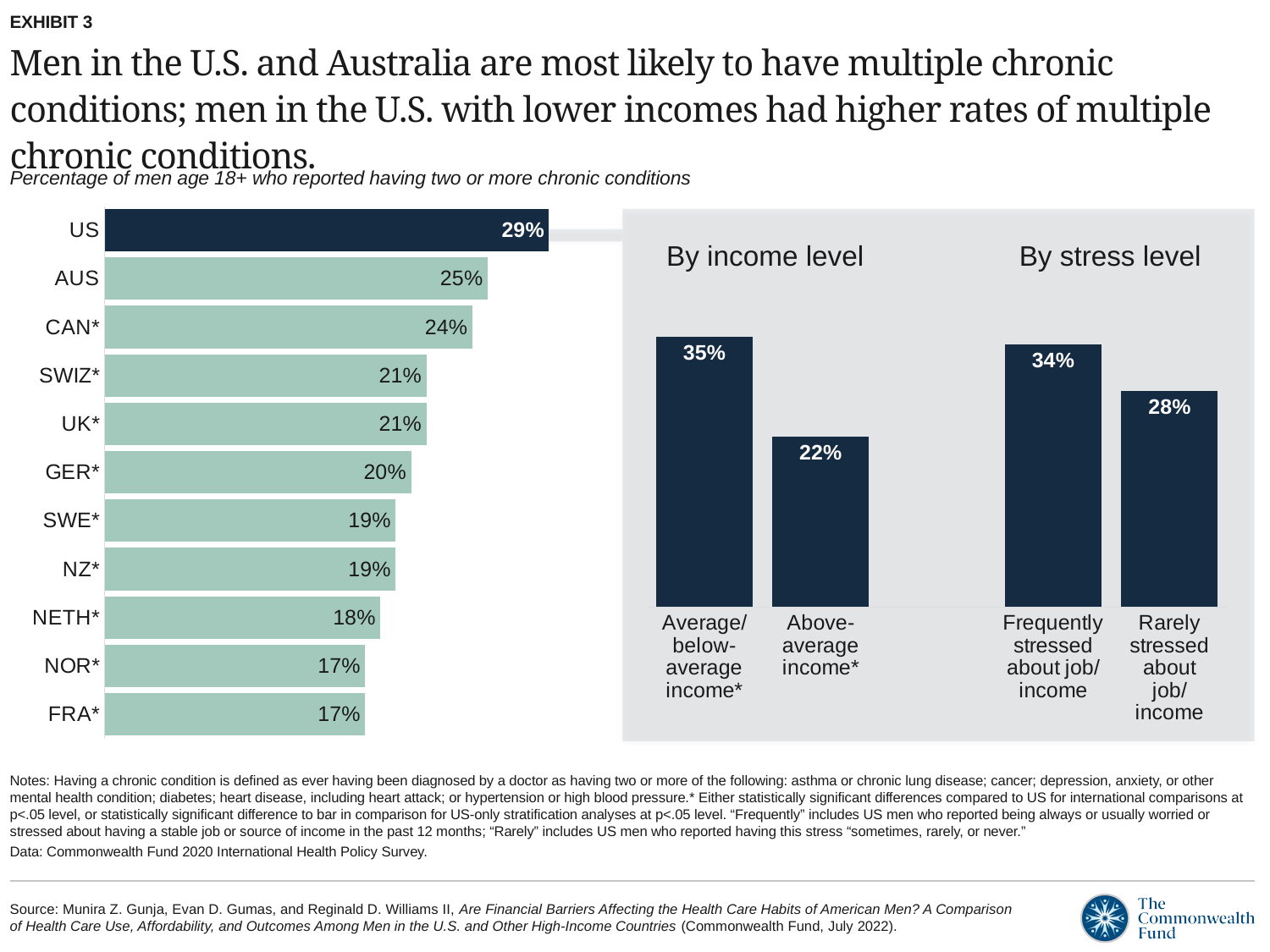
In the country bar chart on the left, what percentage of men in the US reported having two or more chronic conditions? 29% In the country bar chart on the left, what is the difference between the US value and the CAN* value? 5 percentage points In the 'By income level' chart, what is the difference between the average/below-average income value and the above-average income value? 13 percentage points In the 'By stress level' chart, what is the value for men rarely stressed about job/income? 28% In the 'By income level' chart, what is the value for men with average/below-average income? 35% In the country bar chart on the left, what is the value for GER*? 20% In the country bar chart on the left, which country has the highest percentage? US What kind of chart is the country chart on the left? Bar chart In the country bar chart on the left, what is the value for AUS? 25% In the country bar chart on the left, how many countries are shown? 11 In the country bar chart on the left, which is larger, the value for SWE* or the value for NETH*? SWE* In the 'By stress level' chart, which group has the higher value, frequently stressed or rarely stressed? Frequently stressed